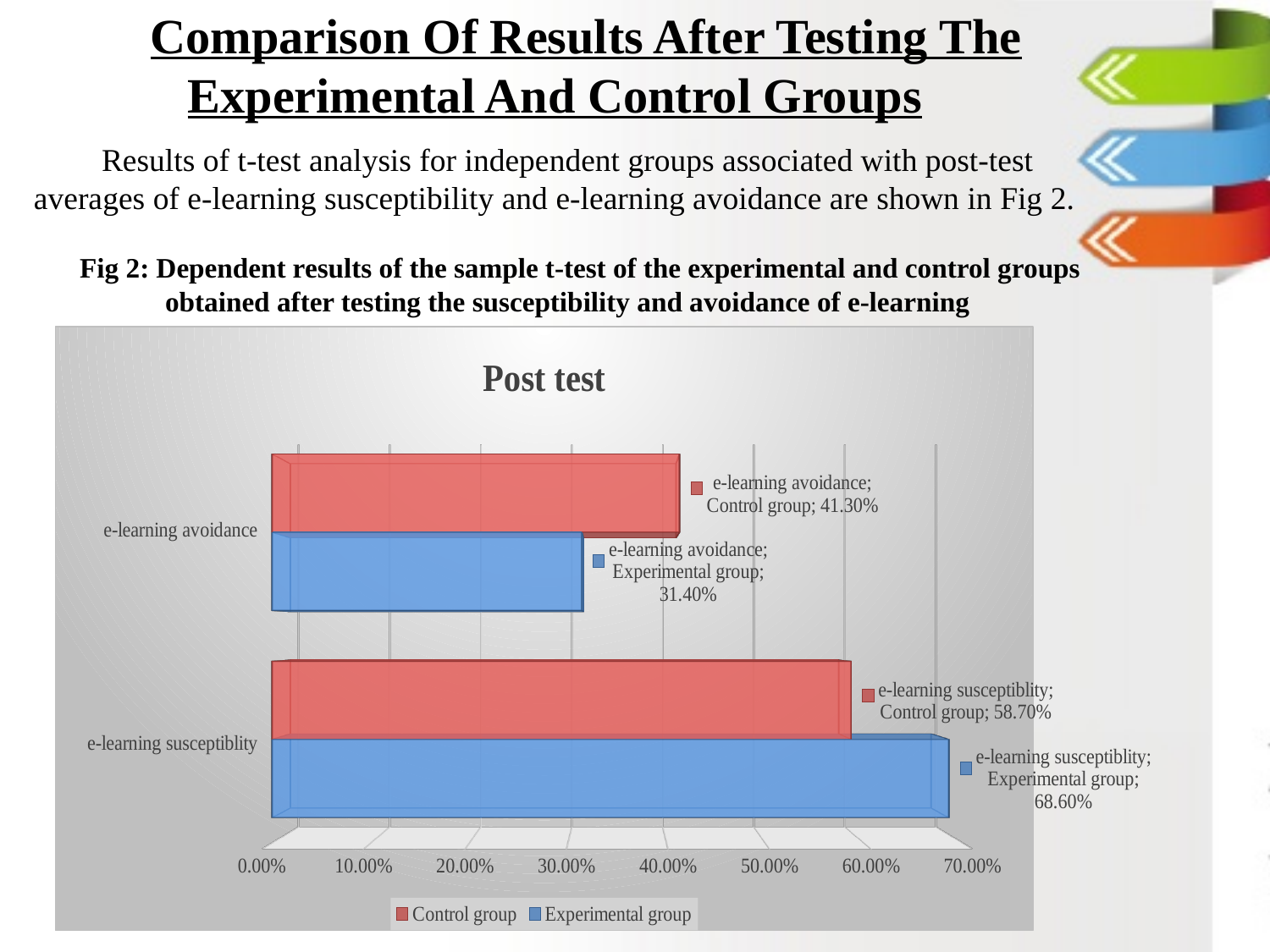
What is the value for the Control group for e-learning susceptiblity? 58.70% What is the difference between the Experimental group and Control group values for e-learning susceptiblity? 9.90% What is the title of the chart? Post test What is the value for the Experimental group for e-learning avoidance? 31.40% Which bar has the highest value in the chart? e-learning susceptiblity, Experimental group What is the value for the Control group for e-learning avoidance? 41.30% Which group has the higher value for e-learning susceptiblity? Experimental group How many series does the legend list? 2 Which group has the higher value for e-learning avoidance? Control group What is the difference between the Control group and Experimental group values for e-learning avoidance? 9.90% Which bar has the lowest value in the chart? e-learning avoidance, Experimental group What is the value for the Experimental group for e-learning susceptiblity? 68.60%